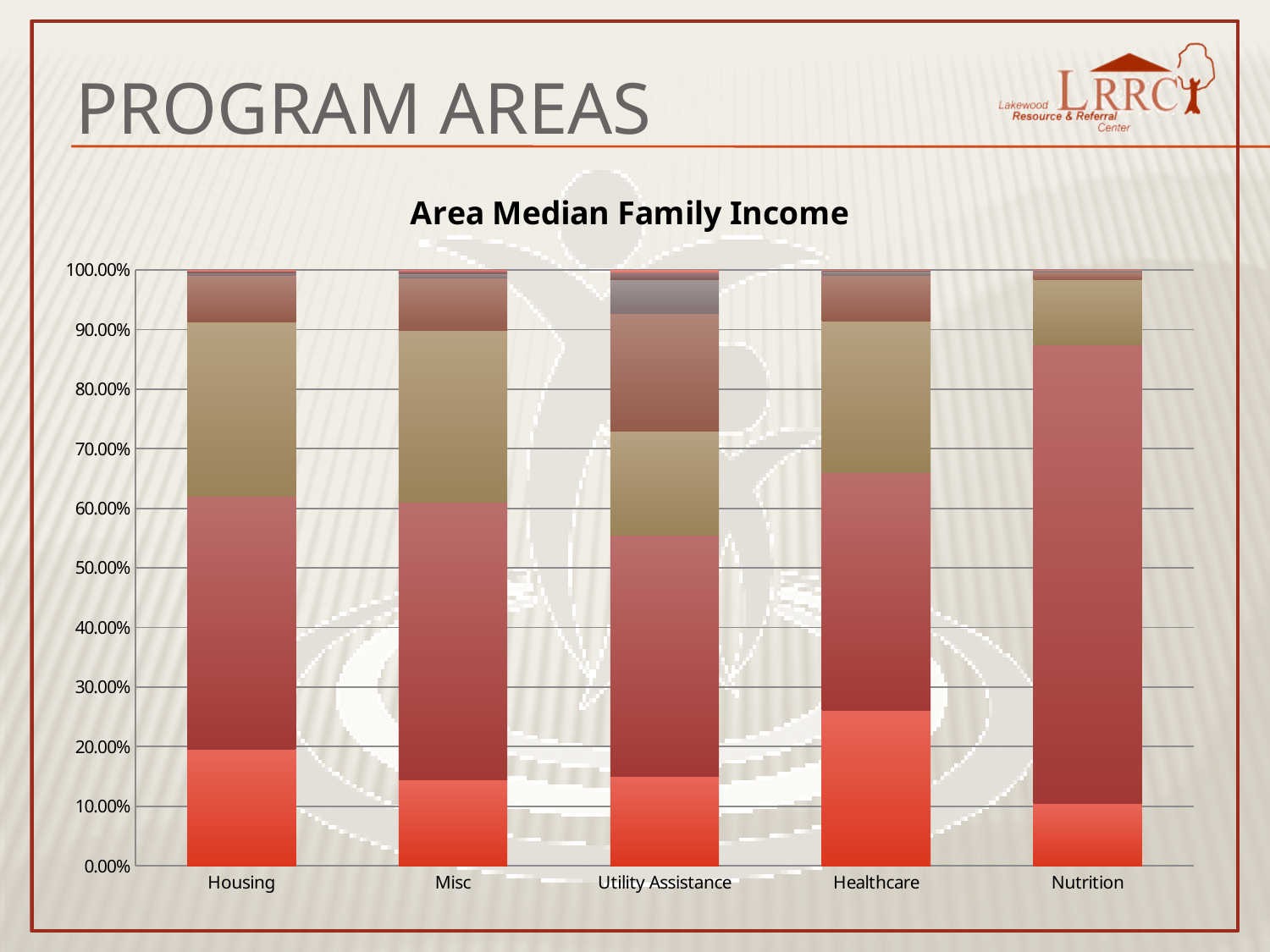
What kind of chart is shown on the slide? stacked bar chart Is the bottom (orange) segment of the Healthcare bar greater or less than 20.00%? greater What is the title of the chart? Area Median Family Income Which category has the largest dark red (second from bottom) segment? Nutrition What value does the top of the Housing stacked bar reach on the y axis? 100.00% Which category has the largest bottom (orange) segment? Healthcare How many categories are shown on the x axis of the chart? 5 Is the bottom (orange) segment larger for Healthcare or for Misc? Healthcare Is the bottom (orange) segment of the Utility Assistance bar greater or less than 20.00%? less Which category has the smallest bottom (orange) segment? Nutrition Which category is shown furthest to the right on the x axis? Nutrition Is the bottom (orange) segment of the Nutrition bar greater or less than 20.00%? less